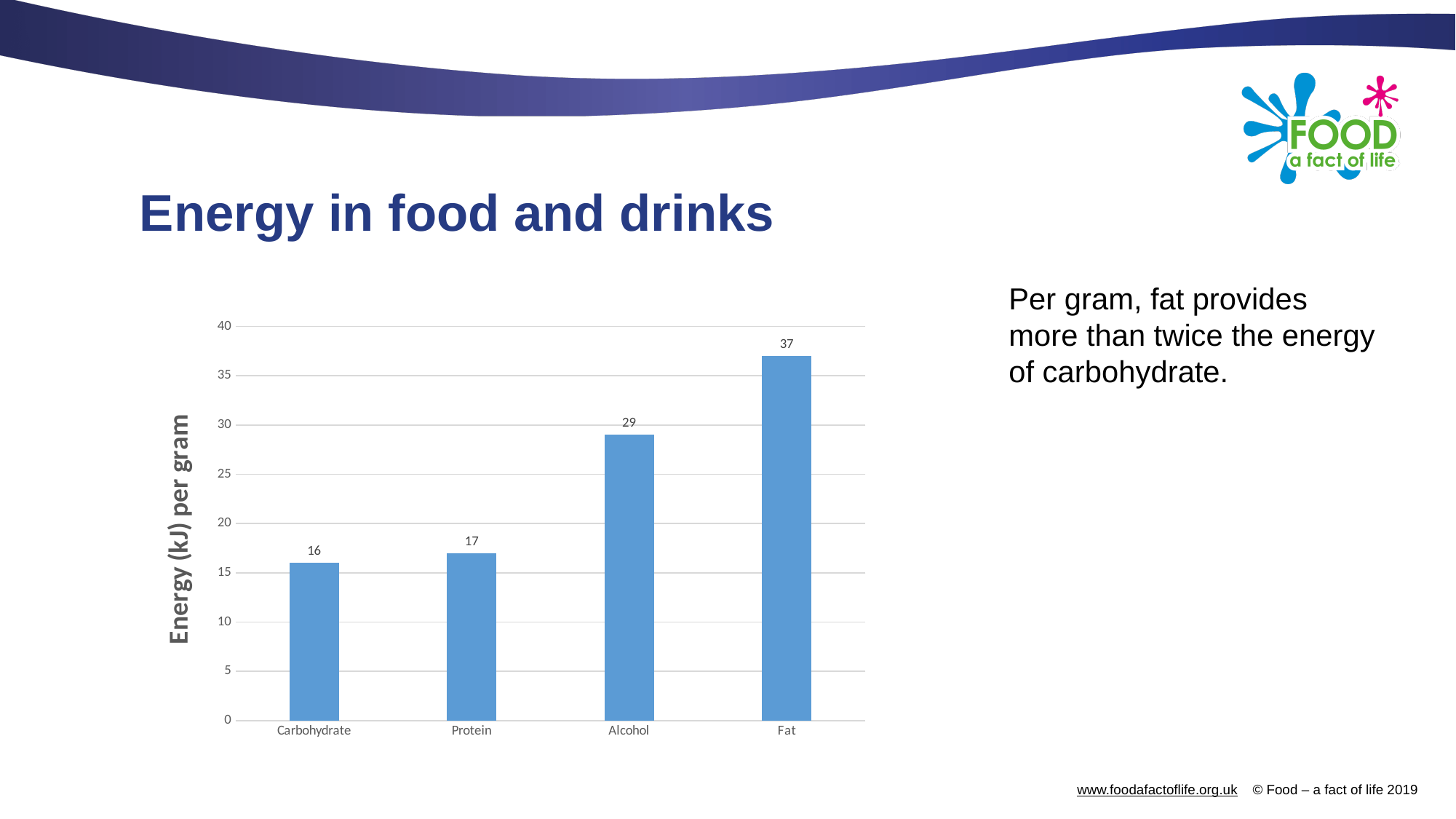
What is the difference in energy per gram between Fat and Carbohydrate? 21 What is the difference in energy per gram between Alcohol and Protein? 12 What is the energy per gram for Carbohydrate? 16 Which category has the lowest energy per gram? Carbohydrate What is the energy per gram for Protein? 17 What is the energy per gram for Fat? 37 What is the energy per gram for Alcohol? 29 Which category has the highest energy per gram? Fat What is the label of the vertical axis? Energy (kJ) per gram Which provides more energy per gram, Alcohol or Fat? Fat How many categories are shown on the chart? 4 What kind of chart is shown on the slide? Bar chart